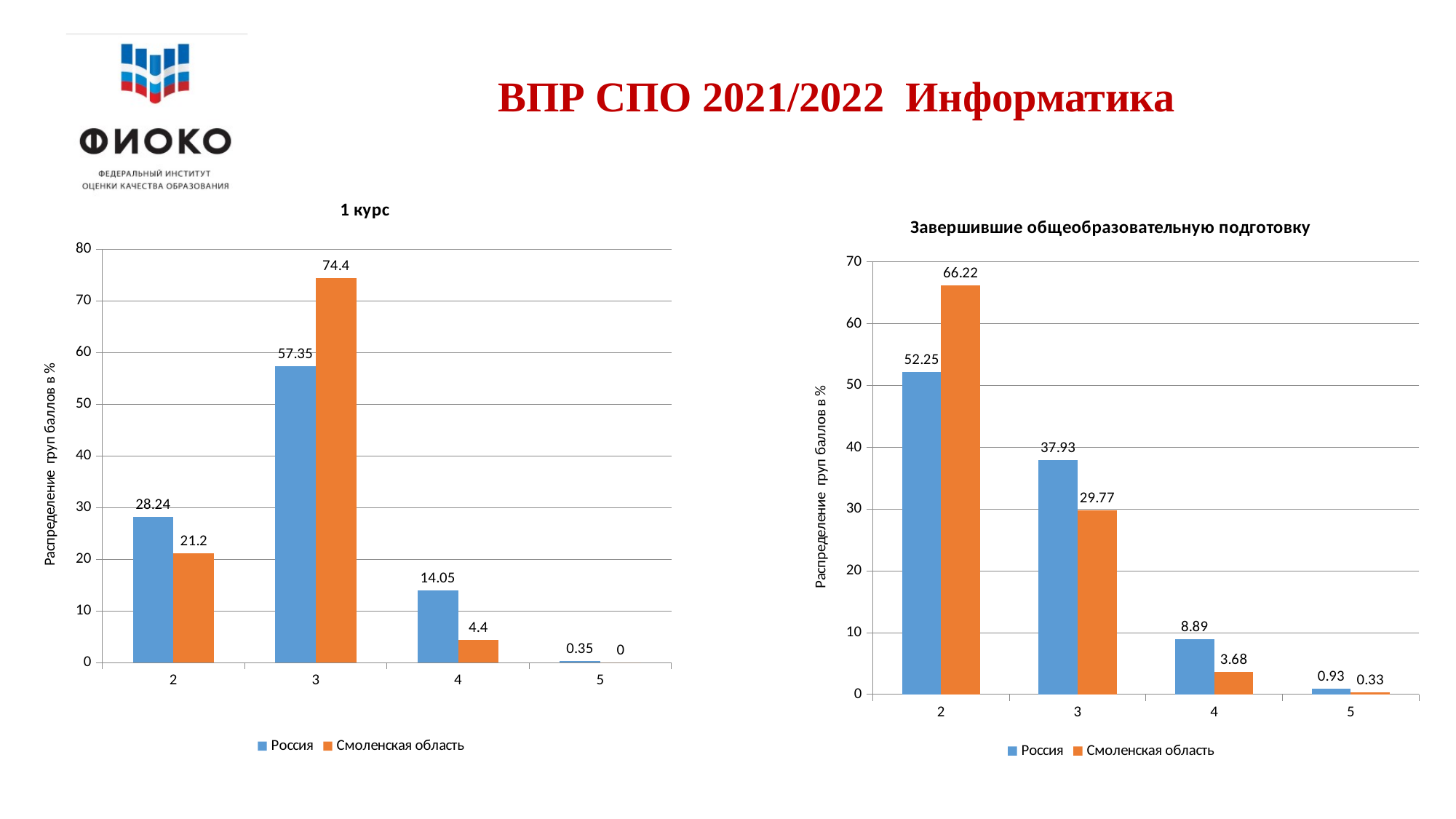
What kind of chart is the '1 курс' chart? Bar chart In the 'Завершившие общеобразовательную подготовку' chart, which category has the lowest value for Смоленская область? 5 In the '1 курс' chart, what is the difference between Россия and Смоленская область at category 4? 9.65 In the '1 курс' chart, what is the value for Смоленская область at category 3? 74.4 In the 'Завершившие общеобразовательную подготовку' chart, what is the difference between Смоленская область and Россия at category 2? 13.97 How many series does the legend of the 'Завершившие общеобразовательную подготовку' chart list? 2 In the '1 курс' chart, what is the value for Россия at category 2? 28.24 In the 'Завершившие общеобразовательную подготовку' chart, what is the value for Смоленская область at category 2? 66.22 In the '1 курс' chart, which category has the highest value for Россия? 3 In the 'Завершившие общеобразовательную подготовку' chart, which is larger at category 3: Россия or Смоленская область? Россия In the '1 курс' chart, what is the value for Смоленская область at category 5? 0 How many categories are shown on the x axis of the '1 курс' chart? 4